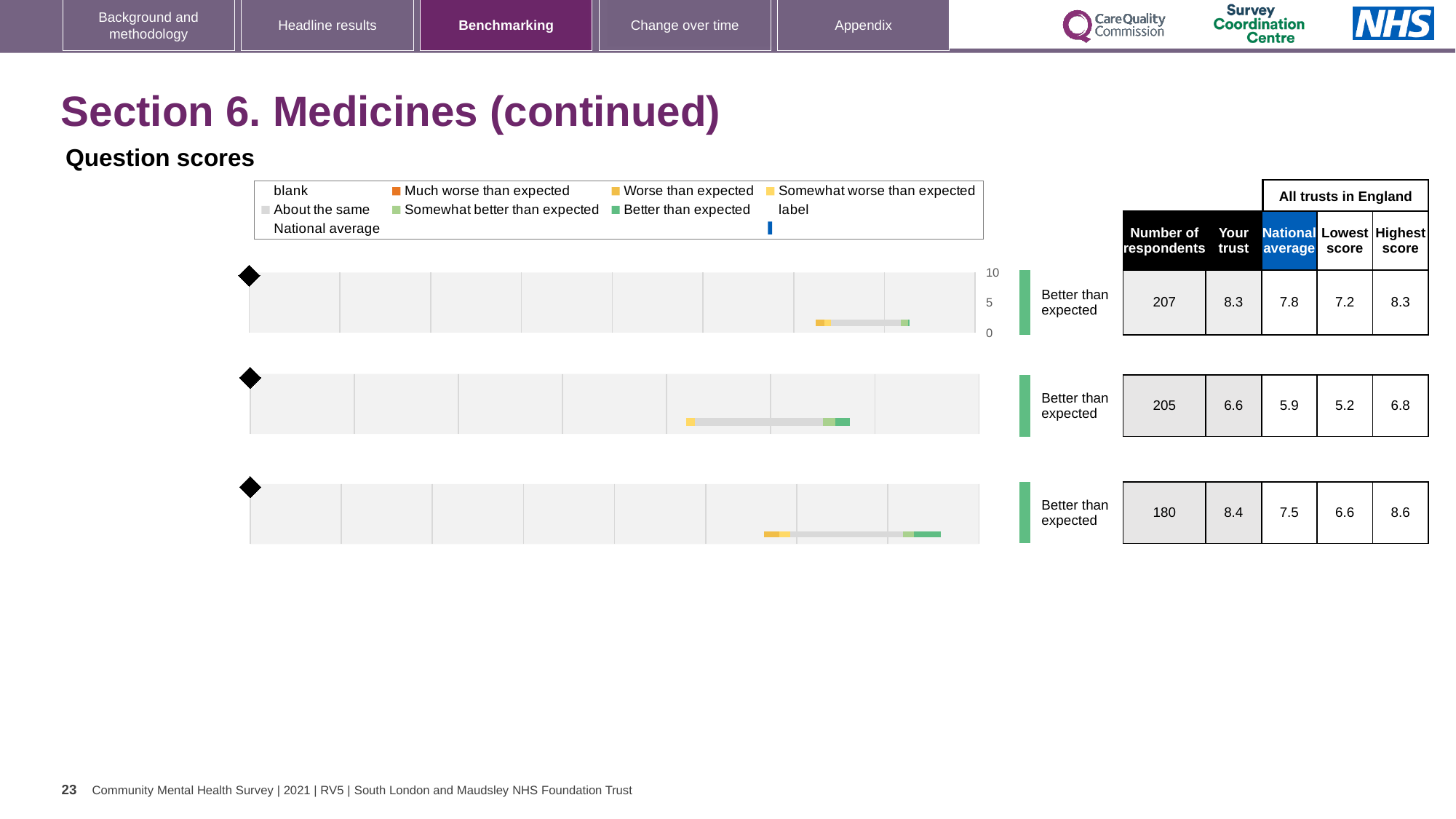
For the middle chart, what is the number of respondents shown in the table? 205 Which of the three charts has the highest 'Your trust' score? the bottom chart (8.4) What is the highest tick value shown on the axis of the top chart? 10 For the bottom chart, what is the national average shown in the table? 7.5 For the middle chart, which is larger: the 'Your trust' score or the national average? Your trust What kind of chart is used for the three benchmarking rows on this slide? bar chart For the top chart, what is the 'Your trust' score shown in the table? 8.3 For the top chart, what is the difference between the 'Your trust' score and the national average? 0.5 How many benchmarking charts are shown on the slide? 3 Which of the three charts has the lowest number of respondents? the bottom chart (180) What benchmark category label is printed beside each of the three charts? Better than expected For the middle chart, what is the highest score among all trusts in England? 6.8